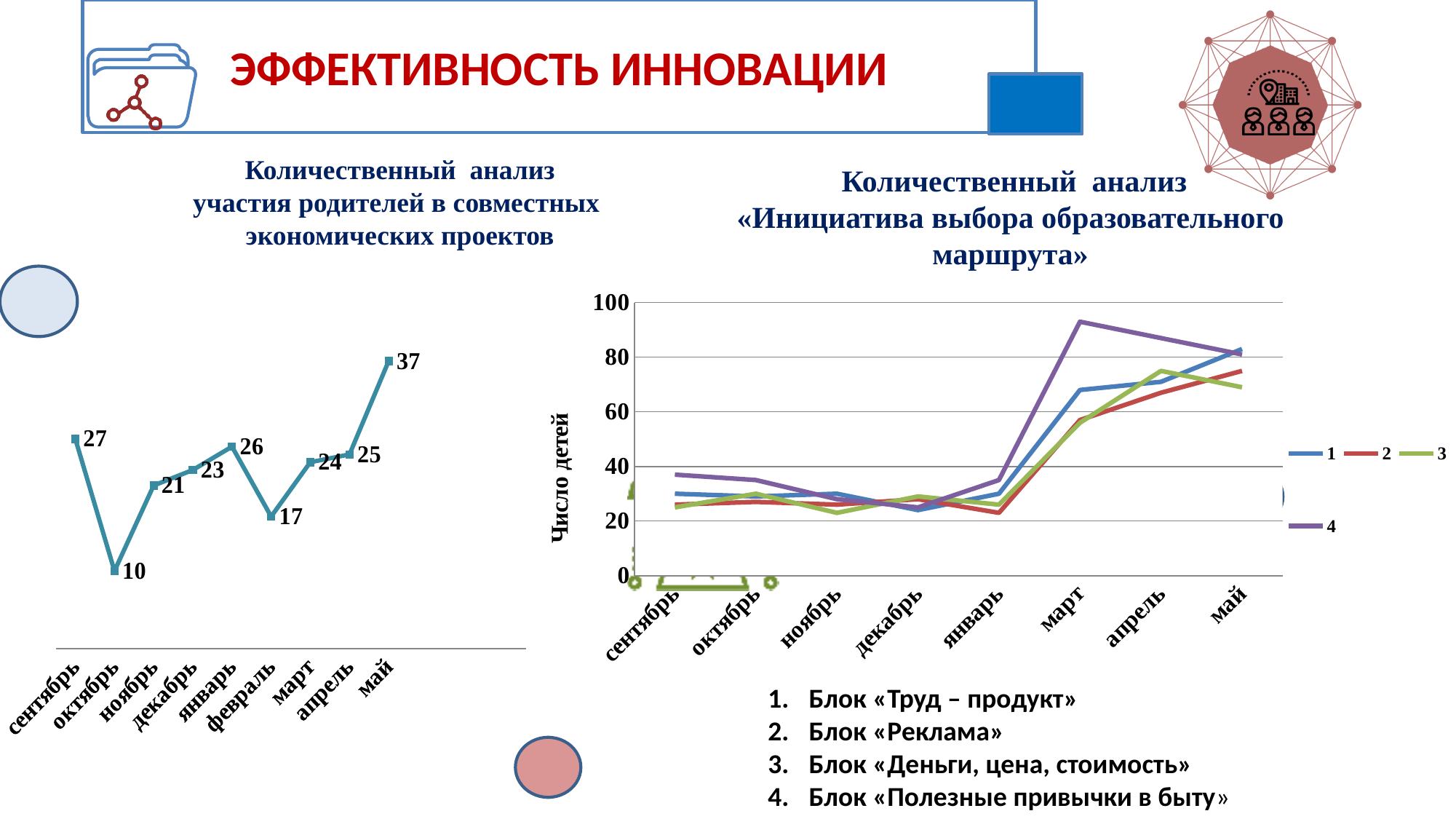
On the left chart (Количественный анализ участия родителей в совместных экономических проектах), what is the value for май? 37 On the left chart, which month has the highest value? май On the right chart (Количественный анализ «Инициатива выбора образовательного маршрута»), how many series does the legend list? 4 On the left chart, what is the difference between the values for май and сентябрь? 10 On the right chart, is the value for series 4 in март greater or less than 80? greater On the left chart, what is the value for октябрь? 10 On the left chart, which is larger: the value for январь or the value for март? январь On the left chart, how many months are plotted? 9 What kind of chart is the right chart? line chart On the left chart, what is the value for февраль? 17 On the right chart, is the value for series 2 in январь greater or less than 40? less On the left chart, which month has the lowest value? октябрь